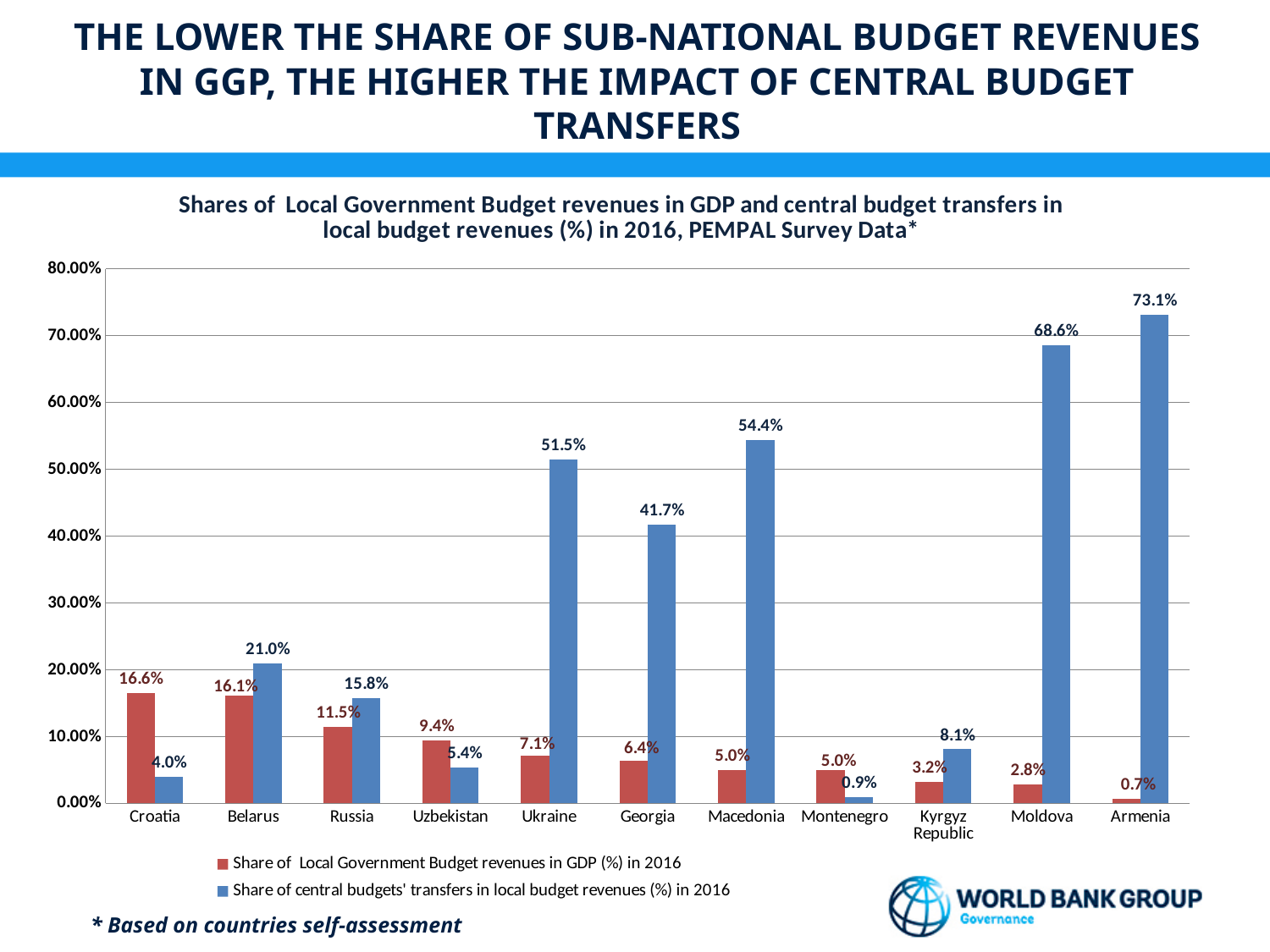
What is the share of central budgets' transfers in local budget revenues for Ukraine? 51.5% Is the share of central budgets' transfers in local budget revenues for Georgia greater or less than 40.00%? greater How many countries are shown on the x axis of the chart? 11 Which country has the lowest share of Local Government Budget revenues in GDP? Armenia Which is larger for Belarus: the share of Local Government Budget revenues in GDP or the share of central budgets' transfers in local budget revenues? Share of central budgets' transfers in local budget revenues What is the difference between Moldova's and Macedonia's share of central budgets' transfers in local budget revenues? 14.2% What type of chart is shown on the slide? Bar chart Which country has the lowest share of central budgets' transfers in local budget revenues? Montenegro What is the share of Local Government Budget revenues in GDP for Croatia? 16.6% What is the share of central budgets' transfers in local budget revenues for Armenia? 73.1% How many series does the chart's legend list? 2 Which country has the highest share of central budgets' transfers in local budget revenues? Armenia